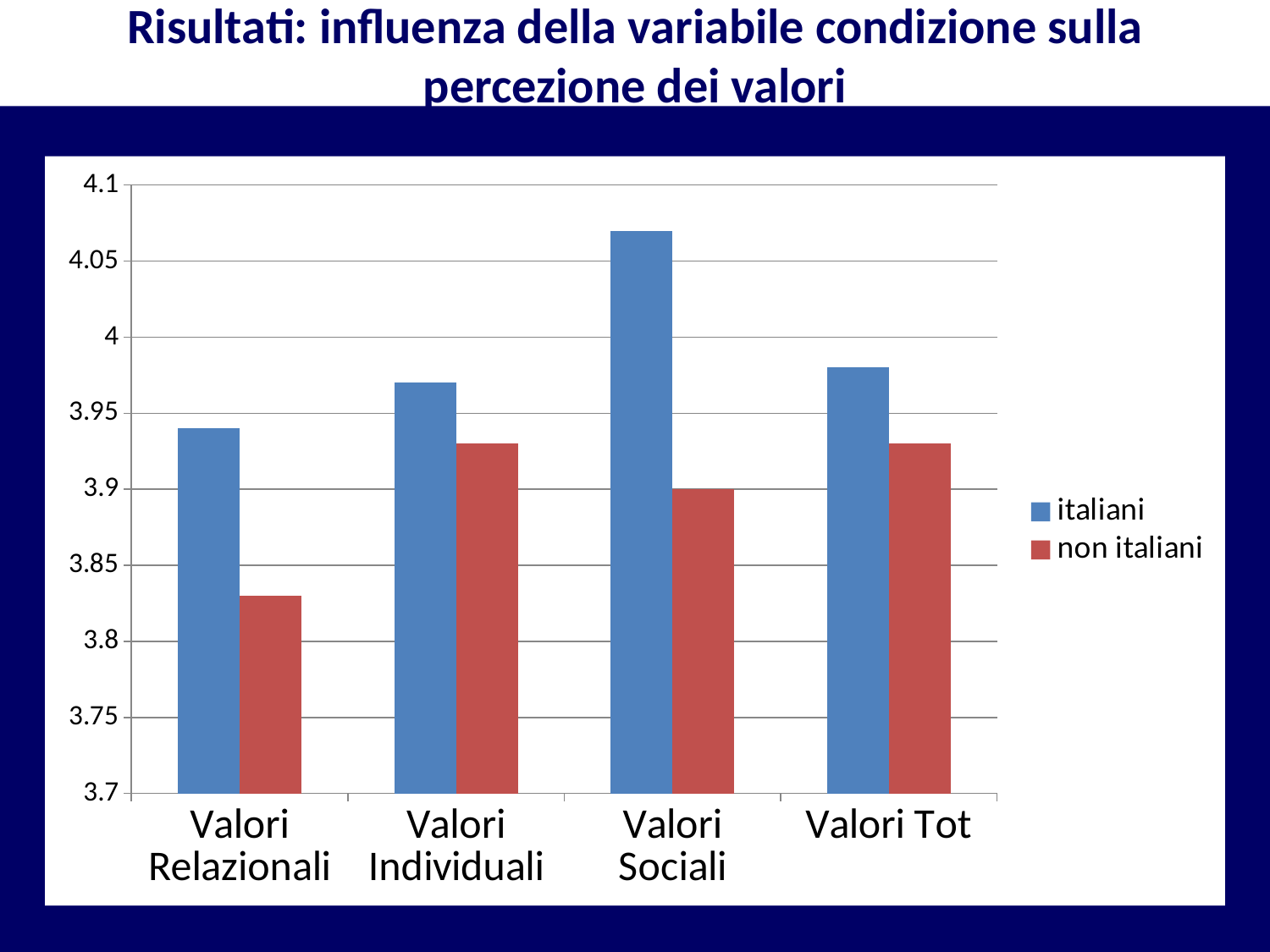
For Valori Relazionali, which series has the larger value, italiani or non italiani? italiani Is the italiani value for Valori Relazionali greater or less than 3.9? greater Is the non italiani value for Valori Relazionali greater or less than 3.9? less What kind of chart is shown on the slide? bar chart Which category has the lowest value for the non italiani series? Valori Relazionali Which series is shown in red in the chart? non italiani Which category has the highest value for the italiani series? Valori Sociali Is the italiani value for Valori Tot greater or less than 3.95? greater How many categories are shown on the x axis of the chart? 4 For Valori Sociali, which series has the larger value, italiani or non italiani? italiani How many series does the chart's legend list? 2